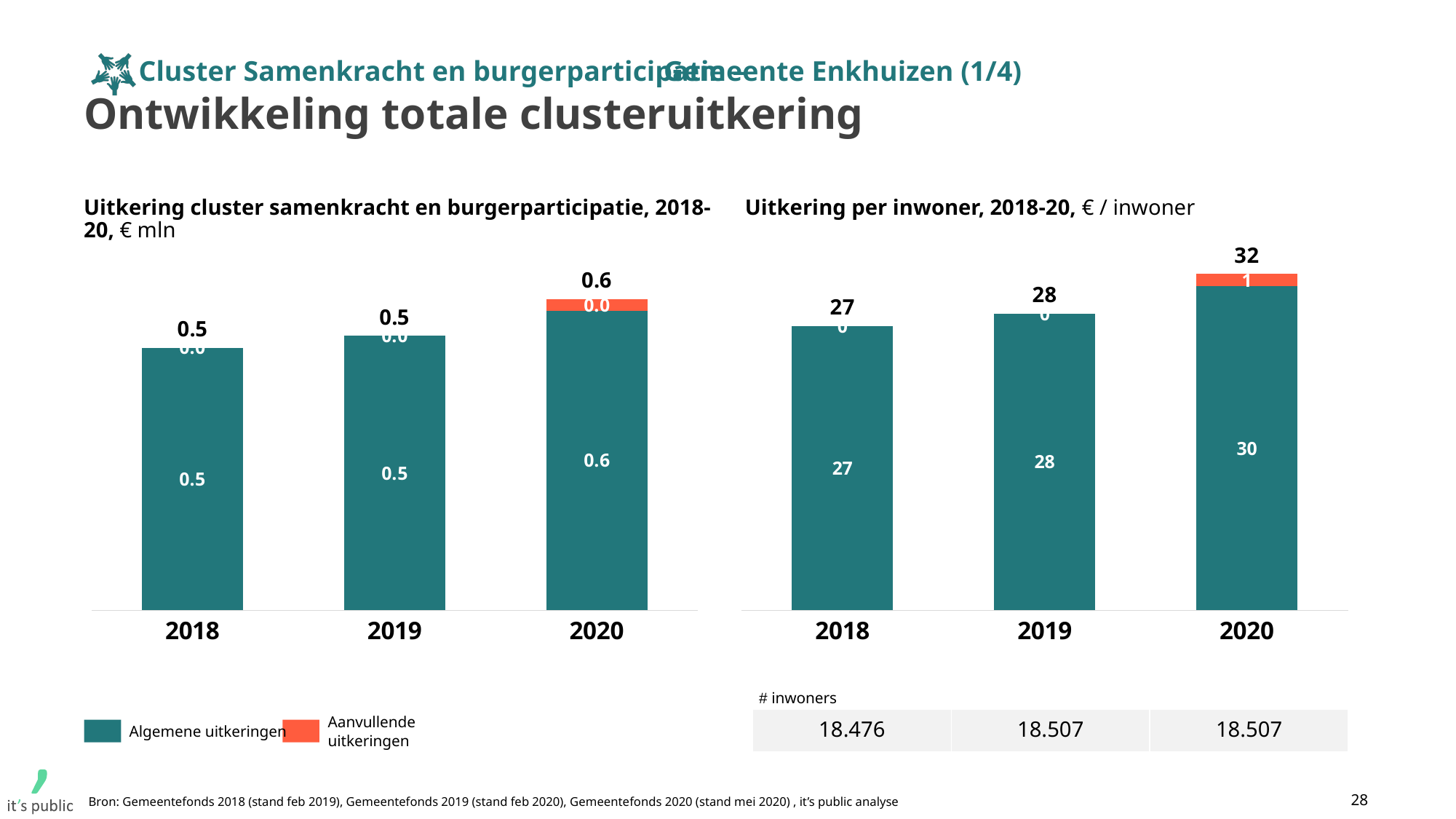
In the left chart (Uitkering cluster samenkracht en burgerparticipatie), what is the total value shown above the 2020 bar? 0.6 How many series does the legend list for the charts on this slide? 2 In the right chart (Uitkering per inwoner), which year has the highest total? 2020 In the right chart (Uitkering per inwoner), what is the total shown above the 2019 bar? 28 In the right chart (Uitkering per inwoner), what is the difference between the 2020 total and the 2018 total? 5 How many years are shown on the x axis of the left chart (Uitkering cluster samenkracht en burgerparticipatie)? 3 In the right chart (Uitkering per inwoner), which year has the lowest total? 2018 In the right chart (Uitkering per inwoner), what is the value of Algemene uitkeringen for 2020? 30 In the right chart (Uitkering per inwoner), is the Algemene uitkeringen value larger in 2019 or in 2020? 2020 In the right chart (Uitkering per inwoner), what is the value of Aanvullende uitkeringen for 2020? 1 What type of chart is the right chart (Uitkering per inwoner)? Stacked bar chart In the left chart (Uitkering cluster samenkracht en burgerparticipatie), what is the value of Algemene uitkeringen for 2018? 0.5